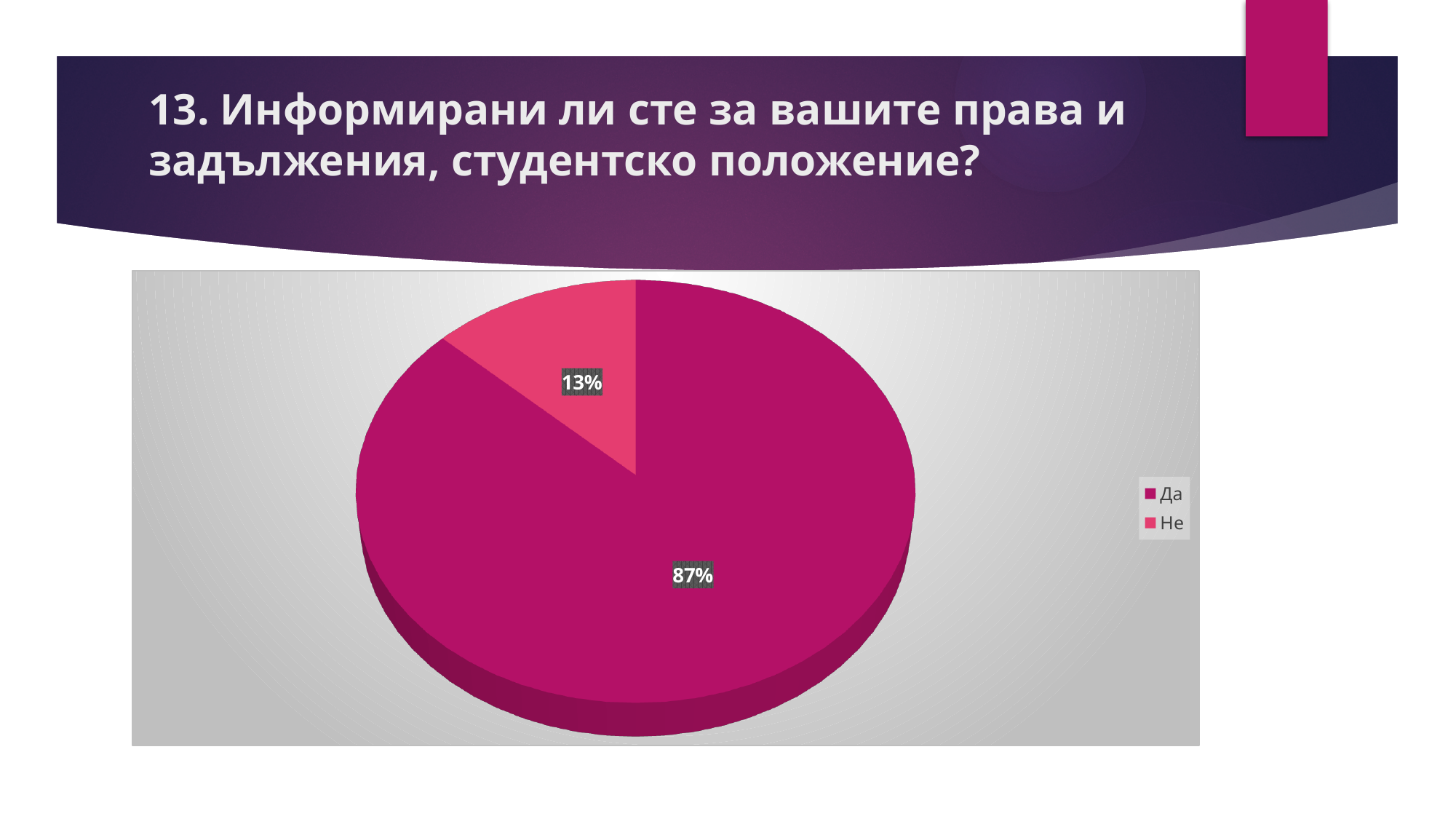
Which is larger, the "Да" slice or the "Не" slice? Да What are the two legend entries of the pie chart? Да, Не Which category has the smallest slice of the pie? Не How many entries does the legend list? 2 What is the total of the two percentages shown on the pie chart? 100% Which category has the largest slice of the pie? Да What share of the pie does the "Не" slice represent? 13% How many slices does the pie chart have? 2 What kind of chart is shown on the slide? pie chart What is the difference in percentage points between the "Да" and "Не" slices? 74 What share of the pie does the "Да" slice represent? 87% Where is the legend positioned relative to the pie? to the right